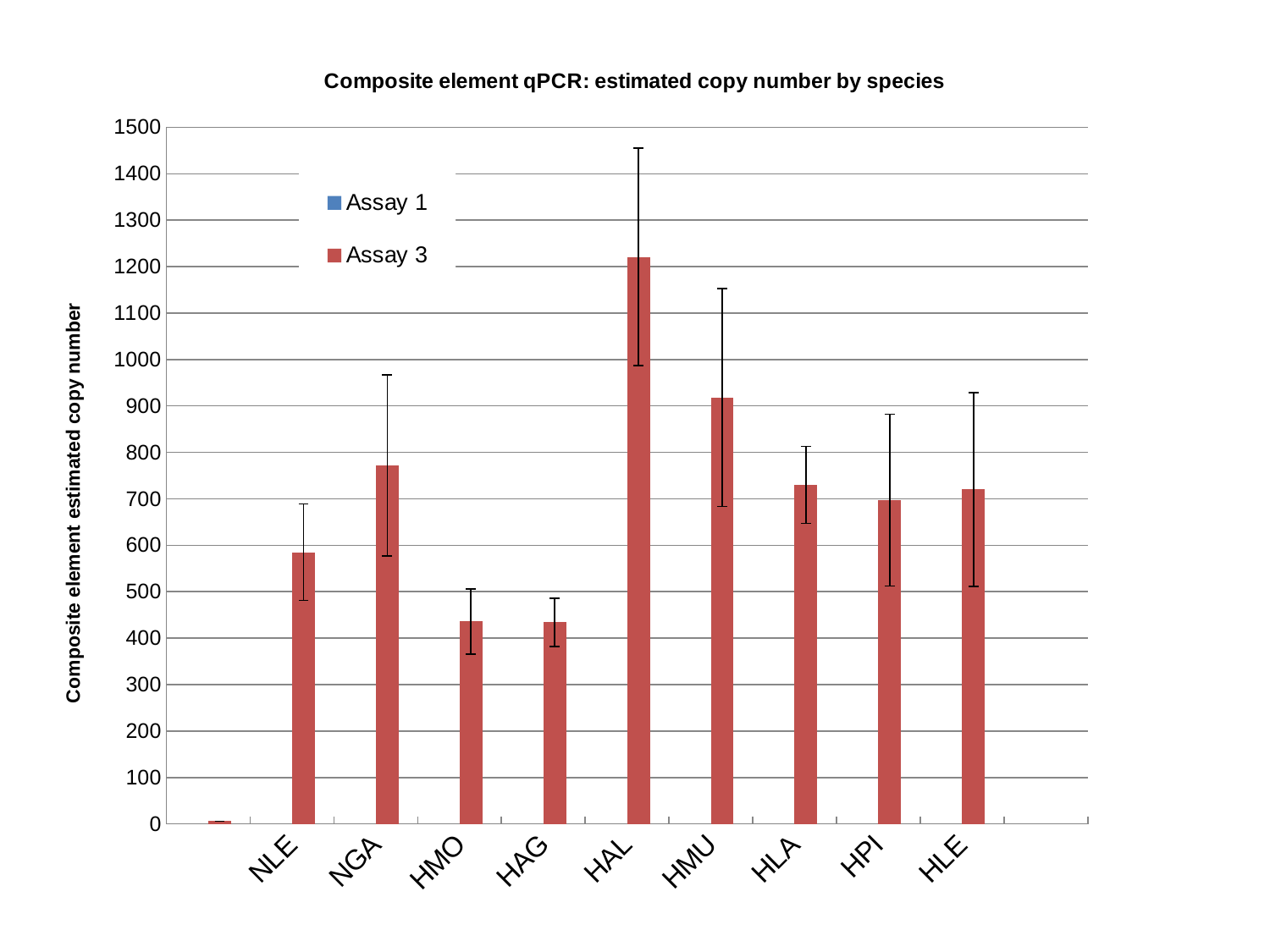
Which has a larger estimated copy number, HAL or HMU? HAL Is the value for HAL greater or less than 1000? greater How many species categories are shown on the x axis? 9 Is the value for HMU greater or less than 800? greater What is the title of the y axis? Composite element estimated copy number What kind of chart is shown on the slide? bar chart How many series does the legend list? 2 Which species has the highest estimated copy number? HAL Is the value for NGA greater or less than 700? greater Which has a larger estimated copy number, NGA or HMO? NGA